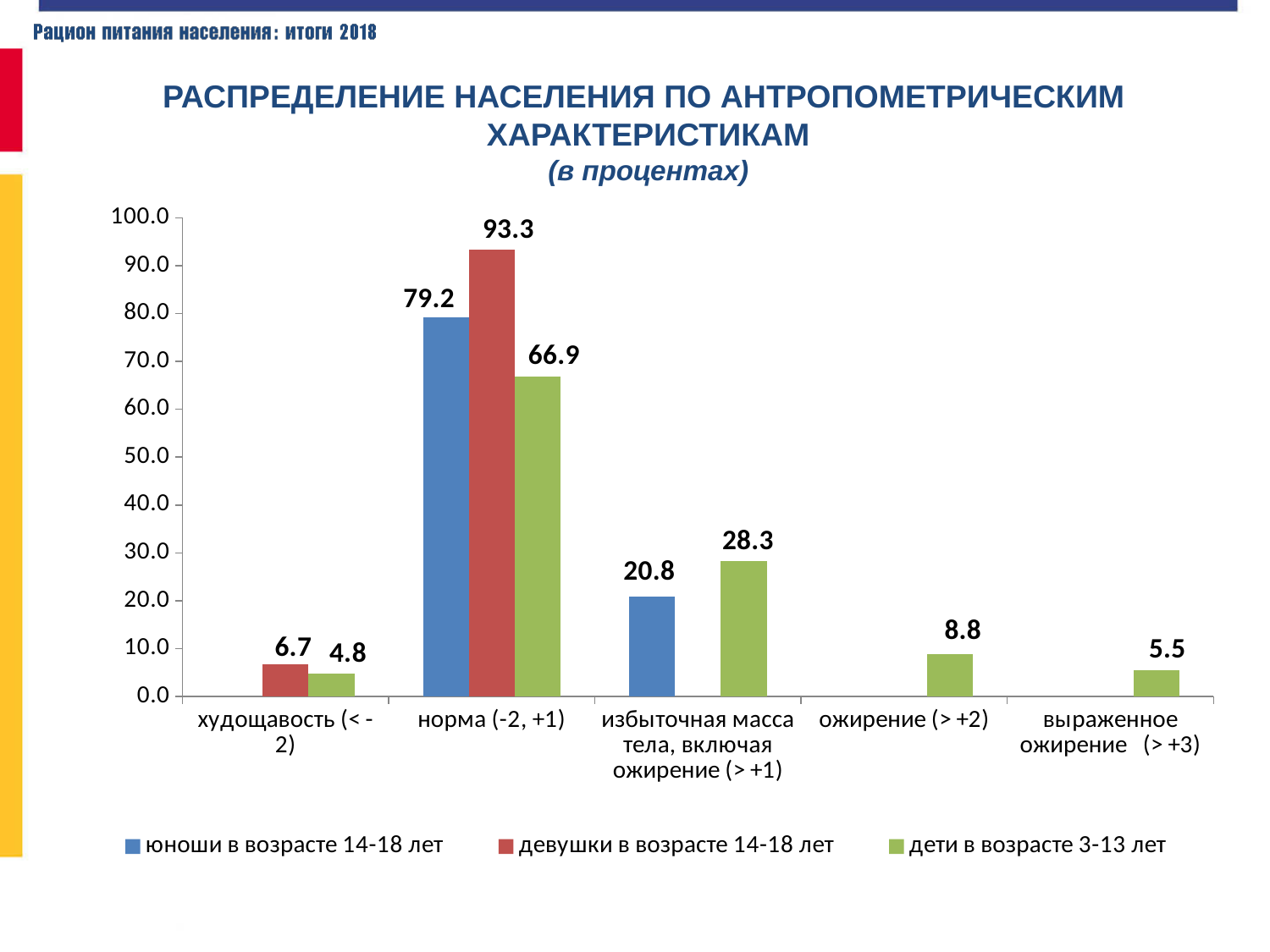
Is the value for дети в возрасте 3-13 лет in the норма (-2, +1) category greater or less than 70.0? less What value is shown for девушки в возрасте 14-18 лет in the норма (-2, +1) category? 93.3 What is the difference between the values for девушки в возрасте 14-18 лет and юноши в возрасте 14-18 лет in the норма (-2, +1) category? 14.1 What colour represents дети в возрасте 3-13 лет in the chart? green What kind of chart is shown on the slide? bar chart What value is shown for дети в возрасте 3-13 лет in the ожирение (> +2) category? 8.8 What value is shown for юноши в возрасте 14-18 лет in the избыточная масса тела, включая ожирение (> +1) category? 20.8 How many categories are shown on the x axis of the chart? 5 Which series has the highest value in the норма (-2, +1) category? девушки в возрасте 14-18 лет How many series does the legend list? 3 In the худощавость (< -2) category, which is larger: the value for девушки в возрасте 14-18 лет or for дети в возрасте 3-13 лет? девушки в возрасте 14-18 лет Which category has the lowest value for дети в возрасте 3-13 лет? худощавость (< -2)